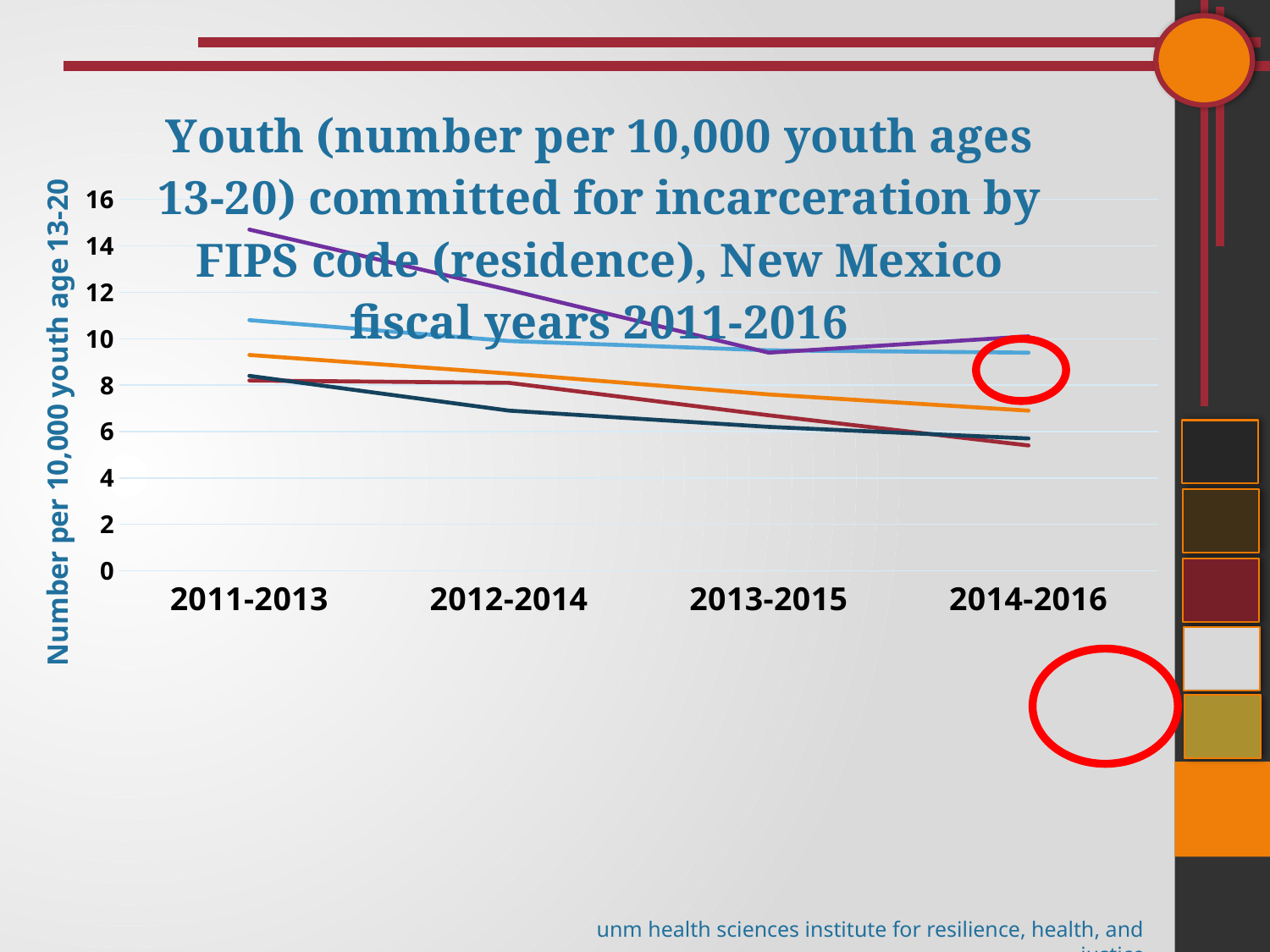
Which line has the lowest value at 2012-2014? the dark teal line At 2011-2013, which is higher: the orange line or the dark red line? the orange line Is the value of the orange line at 2014-2016 greater or less than 8? less What is the label on the y axis? Number per 10,000 youth age 13-20 Does the purple line rise or fall from 2011-2013 to 2013-2015? fall Is the value of the purple line at 2011-2013 greater or less than 12? greater Which fiscal years does the chart title say the data covers? fiscal years 2011-2016 Which line has the highest value at 2011-2013? the purple line What kind of chart is shown on the slide? line chart How many lines are plotted on the chart? 5 Is the value of the light blue line at 2011-2013 greater or less than 10? greater How many fiscal-year periods are shown along the x axis? 4